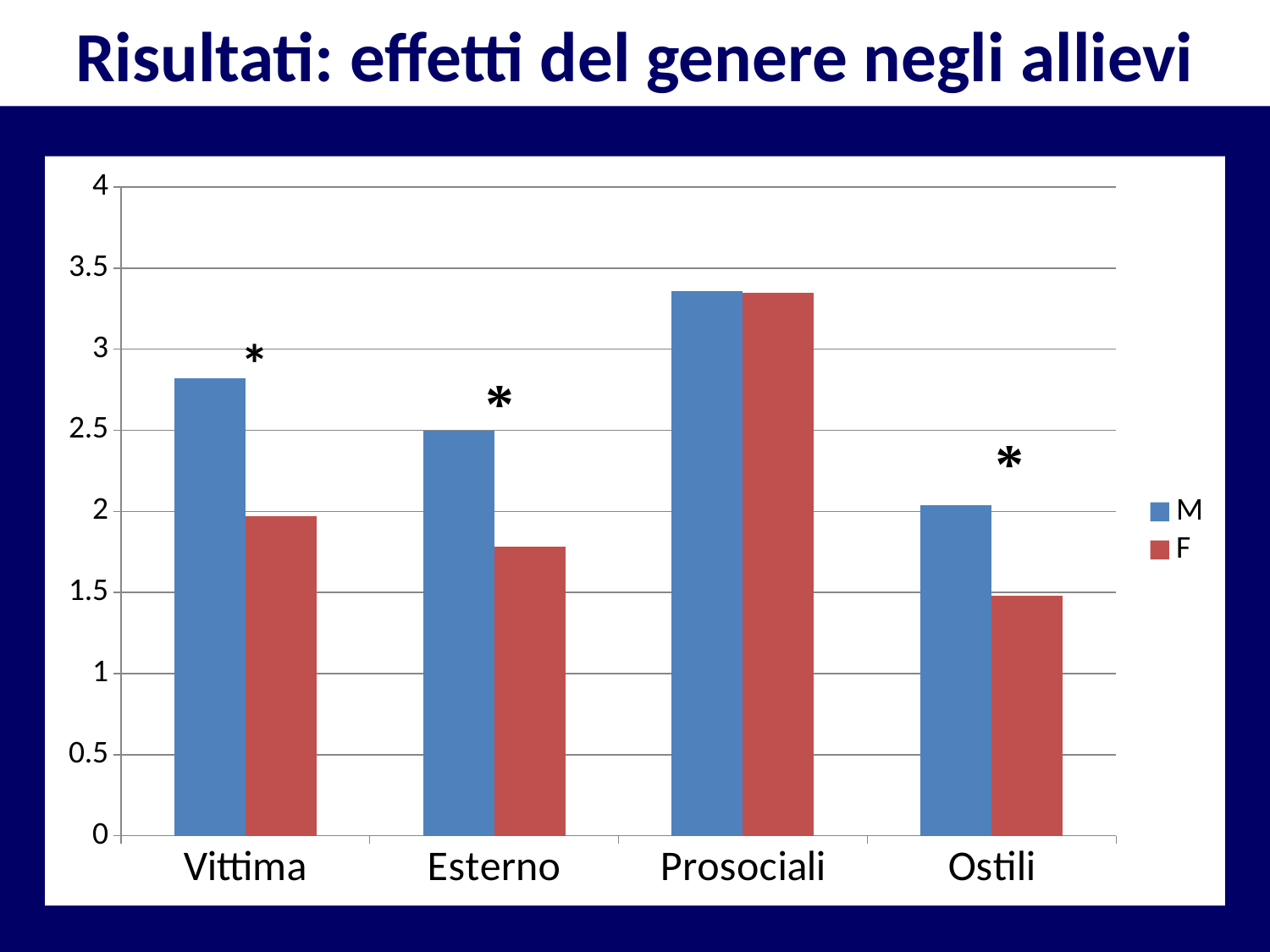
For Vittima, which series has the larger value, M or F? M How many categories are shown on the x axis of the chart? 4 Is the value for M in Prosociali greater or less than 3? greater How many series does the chart's legend list? 2 Which category has the lowest value for the M series? Ostili Which category has the lowest value for the F series? Ostili Is the value for M in Ostili greater or less than 2.5? less What kind of chart is shown on the slide? bar chart What are the two entries listed in the chart's legend? M and F Is the value for M in Vittima greater or less than 2.5? greater Which category has the highest value for the M series? Prosociali